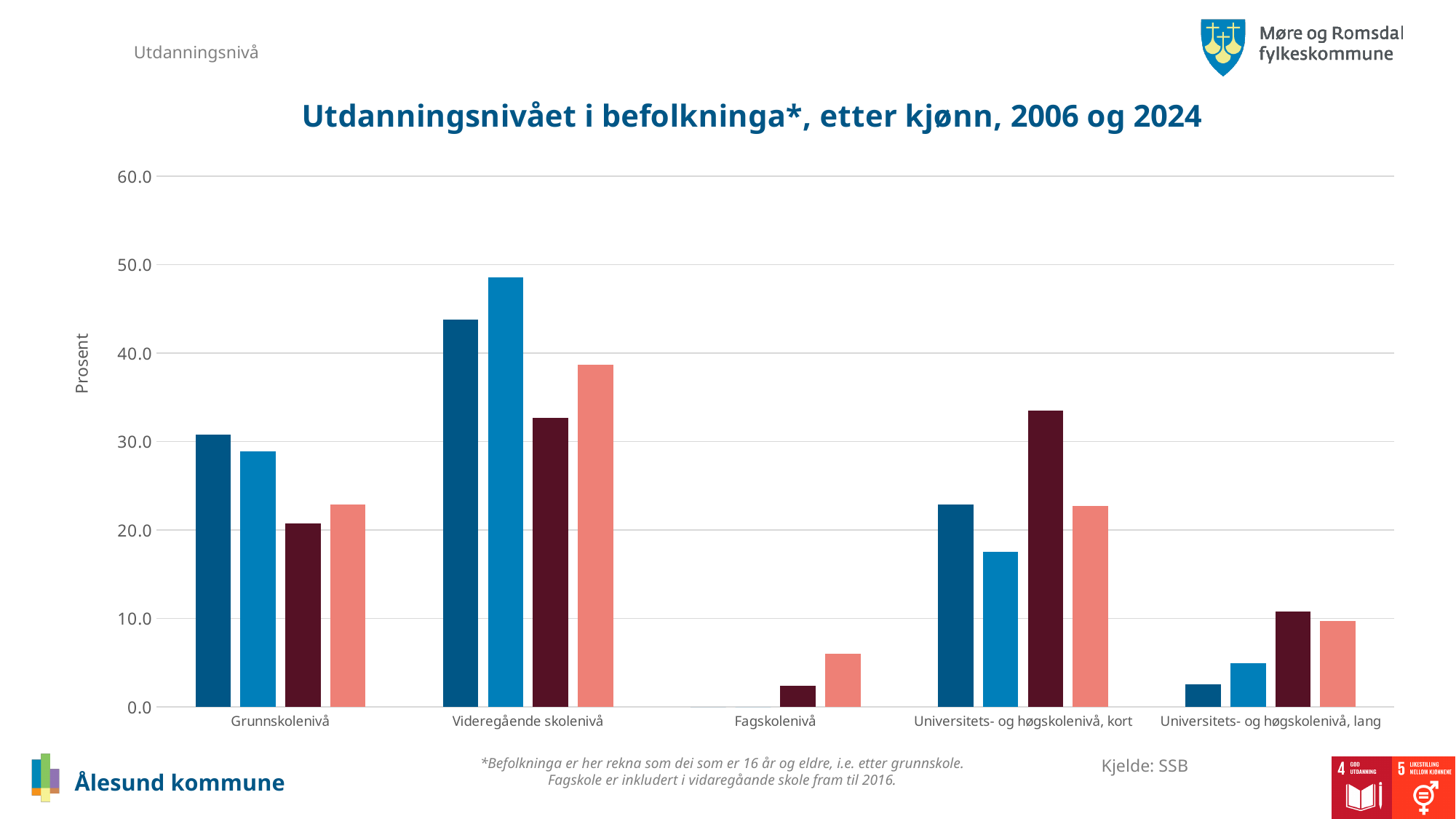
Is the value of the dark blue bar for Grunnskolenivå greater or less than 25? greater For Universitets- og høgskolenivå, kort, which is taller: the dark maroon bar or the salmon bar? the dark maroon bar Is the value of the dark maroon bar for Universitets- og høgskolenivå, kort greater or less than 30? greater Is the value of the light blue bar for Videregående skolenivå greater or less than 40? greater Which category contains the tallest bar in the chart? Videregående skolenivå For Videregående skolenivå, which is taller: the dark blue bar or the light blue bar? the light blue bar How many education-level categories are shown on the x axis? 5 What is the label on the y axis of the chart? Prosent Which category has the lowest bars overall? Fagskolenivå What kind of chart is shown on the slide? bar chart